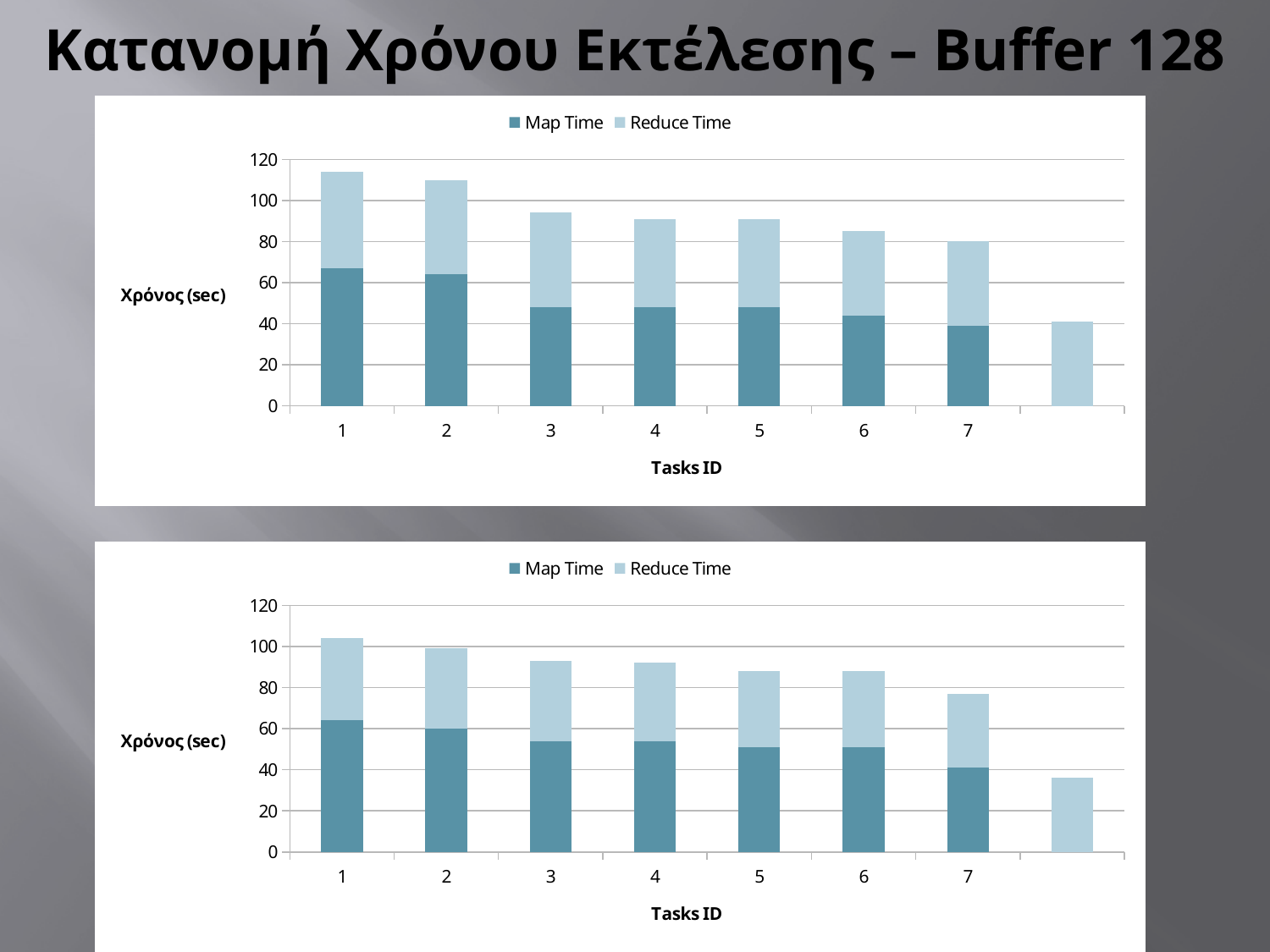
How many series does the legend of the top chart list? 2 In the bottom chart, which of tasks 1 to 7 has the lowest total time? 7 In the top chart, is the total time for task 7 greater or less than 100? less What is the y-axis label of the top chart? Χρόνος (sec) In the top chart, is the Map Time for task 1 greater or less than 60? greater What kind of chart is the top chart on the slide? Stacked bar chart In the bottom chart, is the total time for task 1 greater or less than 80? greater In the top chart, which of tasks 1 to 7 has the highest total time? 1 In the bottom chart, do the total times rise or fall from task 1 to task 7? fall What are the two series named in the legend of the bottom chart? Map Time and Reduce Time